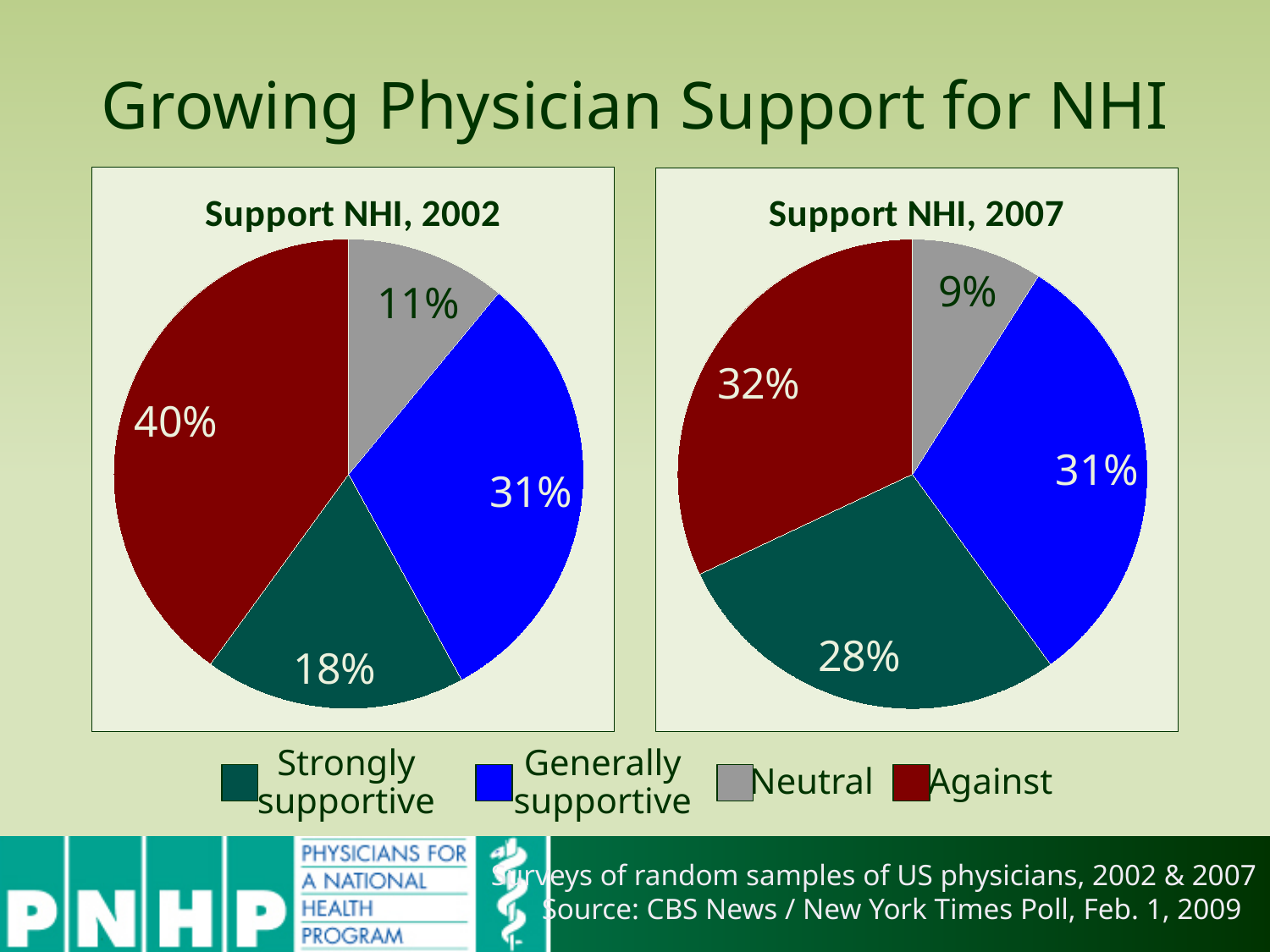
In the 'Support NHI, 2002' chart, which category has the largest slice? Against In the 'Support NHI, 2007' chart, which category has the smallest slice? Neutral What type of chart is 'Support NHI, 2007'? Pie chart In the 'Support NHI, 2002' chart, what percentage of physicians were Against? 40% In the 'Support NHI, 2007' chart, which is larger: the Against slice or the Strongly supportive slice? Against In the 'Support NHI, 2007' chart, what percentage of physicians were Strongly supportive? 28% How many categories does the shared legend list? 4 How many slices does the 'Support NHI, 2002' chart have? 4 In the 'Support NHI, 2002' chart, what percentage of physicians were Neutral? 11% In the legend, which category is shown in blue? Generally supportive What is the difference between the Strongly supportive share in the 'Support NHI, 2007' chart and the Strongly supportive share in the 'Support NHI, 2002' chart? 10% In the 'Support NHI, 2007' chart, what percentage of physicians were Generally supportive? 31%